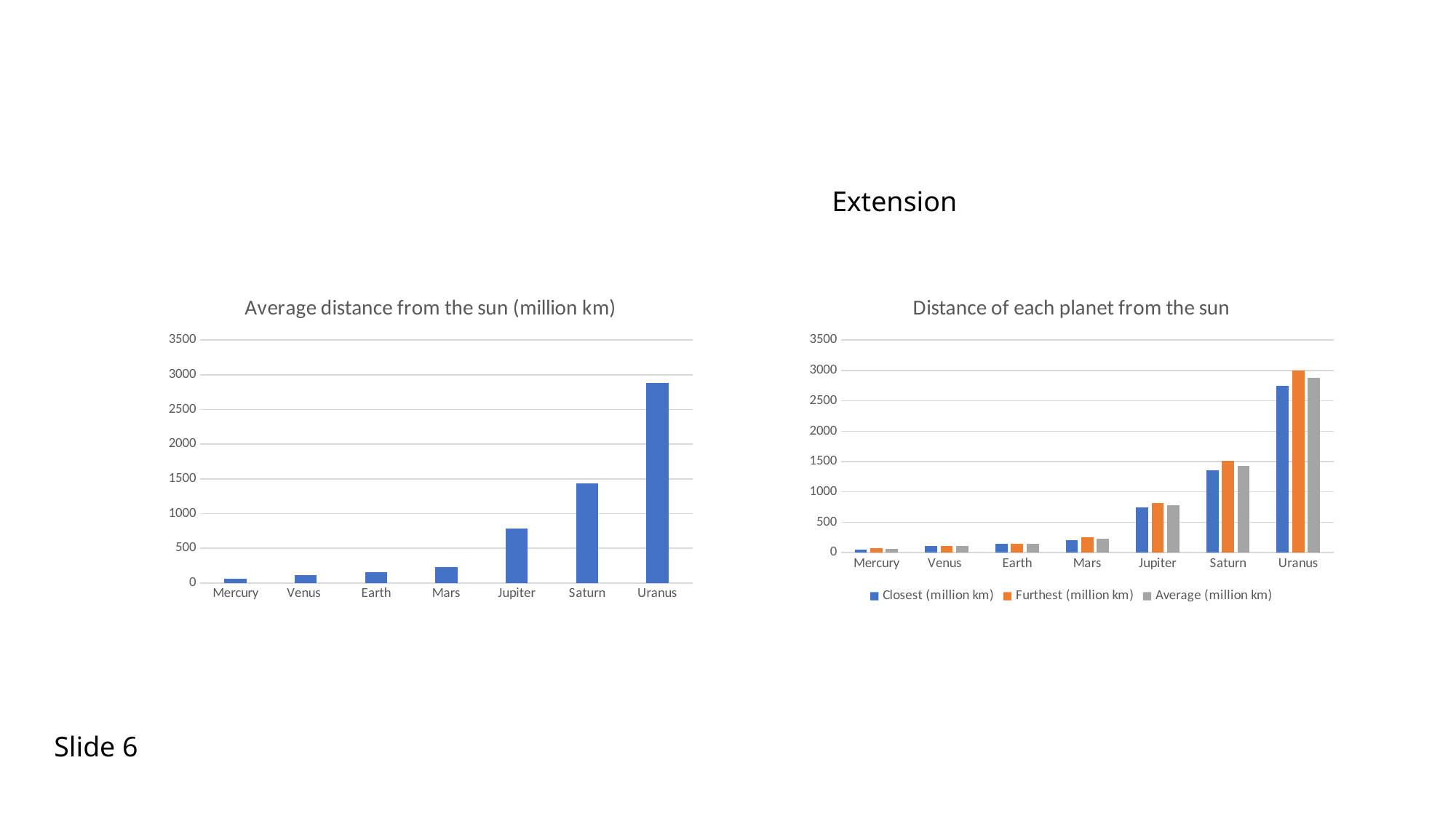
In the 'Average distance from the sun (million km)' chart, which planet has the highest value? Uranus In the 'Distance of each planet from the sun' chart, which series is shown in orange? Furthest (million km) What kind of chart is the 'Average distance from the sun (million km)' chart? Bar chart In the 'Average distance from the sun (million km)' chart, which planet has the lowest value? Mercury In the 'Average distance from the sun (million km)' chart, how many planets are shown on the x axis? 7 In the 'Average distance from the sun (million km)' chart, do the values rise or fall from Mercury to Uranus? Rise In the 'Distance of each planet from the sun' chart, is the Closest value for Jupiter greater or less than 1000? less In the 'Distance of each planet from the sun' chart, how many series does the legend list? 3 In the 'Average distance from the sun (million km)' chart, is the value for Saturn greater or less than 1000? greater In the 'Distance of each planet from the sun' chart, which is larger for Saturn: the Closest value or the Furthest value? Furthest In the 'Distance of each planet from the sun' chart, is the Furthest value for Uranus greater or less than 2500? greater